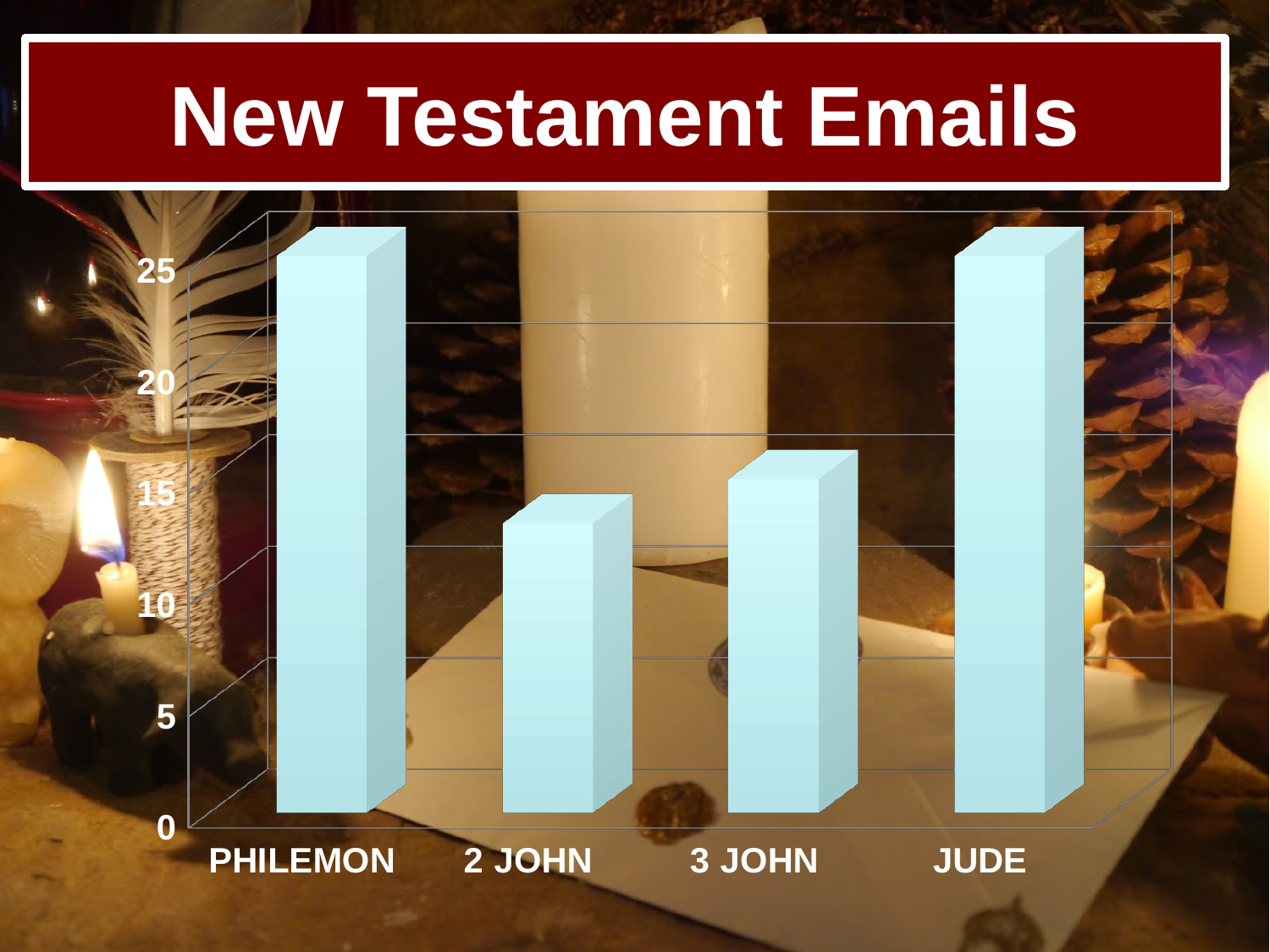
How many categories are shown on the x axis? 4 Is the value for 2 JOHN greater or less than 15? less What is the title of the chart? New Testament Emails Is the value for JUDE greater or less than 20? greater Is the value for 2 JOHN greater or less than 10? greater Which category has the lowest value? 2 JOHN What is the highest value shown on the y axis? 25 What kind of chart is shown on the slide? bar chart Which is larger, the value for 3 JOHN or the value for 2 JOHN? 3 JOHN Which is larger, the value for PHILEMON or the value for 3 JOHN? PHILEMON